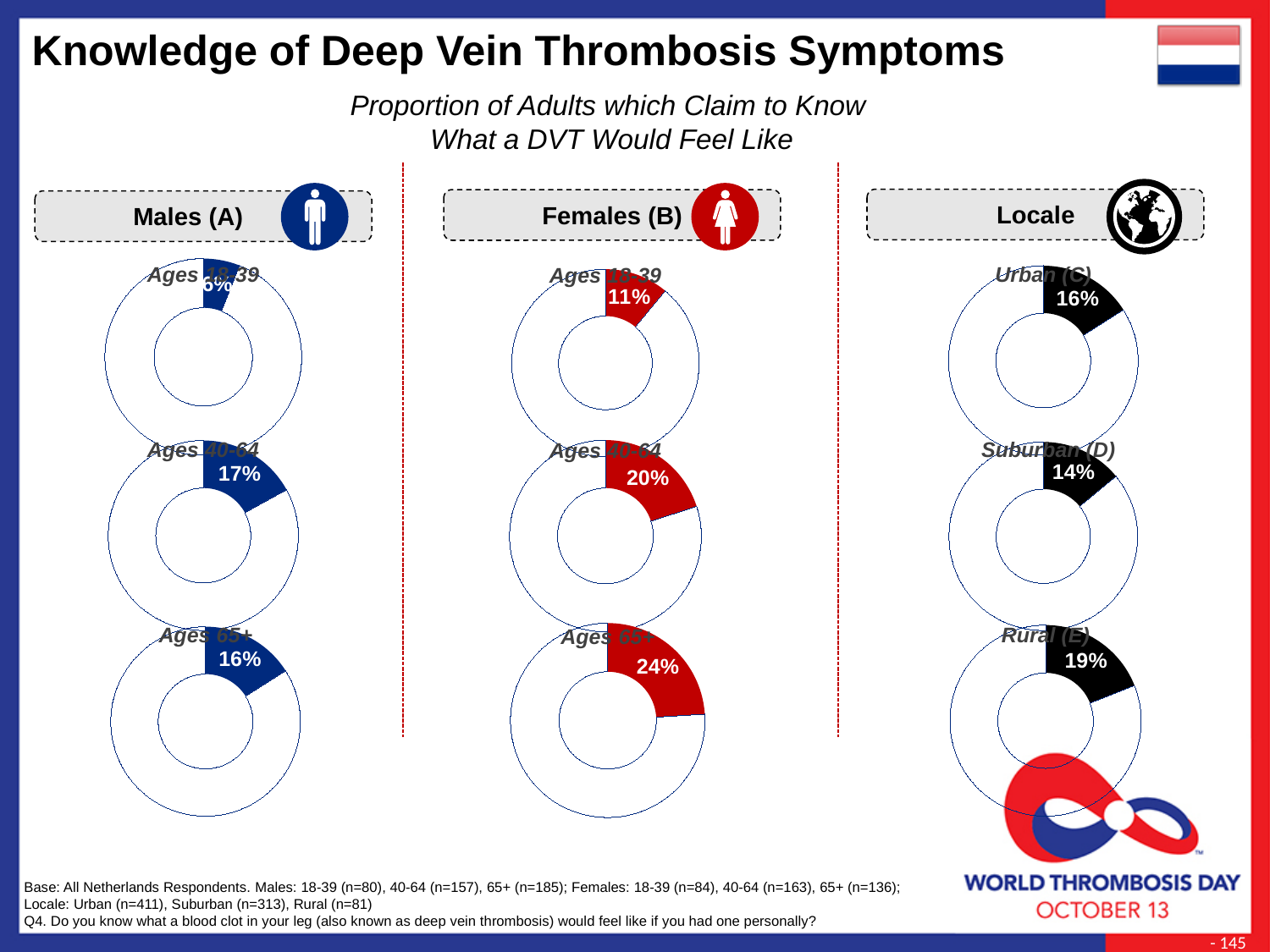
Among the three Males (A) charts, which age group has the lowest percentage? Ages 18-39 What type of chart is used to show each percentage on this slide? Donut (pie) chart In the Females (B) group, what percentage of adults aged 65+ claim to know what a DVT would feel like? 24% Among the three Locale charts, which locale has the lowest percentage? Suburban (D) In the Males (A) group, what percentage of adults aged 18-39 claim to know what a DVT would feel like? 6% Among the three Females (B) charts, which age group has the highest percentage? Ages 65+ How many donut charts are shown on the slide in total? 9 In the Locale group, what is the value shown for Rural (E)? 19% Which is larger: the Males (A) Ages 40-64 value or the Females (B) Ages 40-64 value? Females (B) Ages 40-64 In the Females (B) group, what is the value shown for Ages 40-64? 20% What is the difference between the Urban (C) and Suburban (D) values in the Locale group? 2% What is the difference between the Females (B) Ages 65+ value and the Males (A) Ages 65+ value? 8%